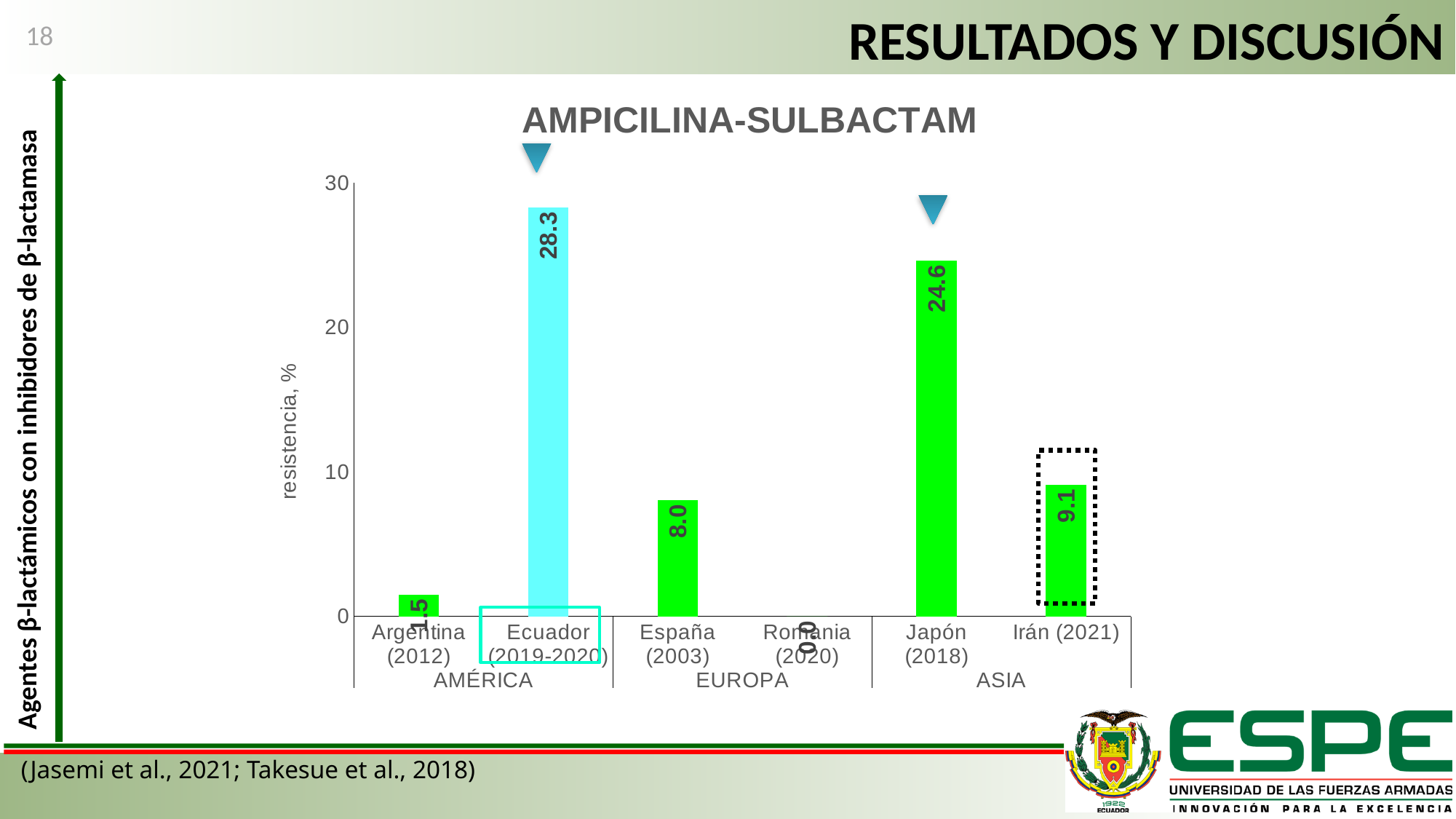
What is the title of the chart? AMPICILINA-SULBACTAM Which country has the highest resistance value? Ecuador (2019-2020) What is the resistance value for Irán (2021)? 9.1 What is the resistance value for España (2003)? 8.0 Is the value for Japón (2018) greater or less than 20? greater What kind of chart is shown? bar chart Which is larger, the value for Irán (2021) or the value for España (2003)? Irán (2021) What is the resistance value for Ecuador (2019-2020)? 28.3 Which country has the lowest resistance value? Romania (2020) What is the resistance value for Japón (2018)? 24.6 What is the difference between the values for Ecuador (2019-2020) and Japón (2018)? 3.7 How many countries are shown in the chart? 6